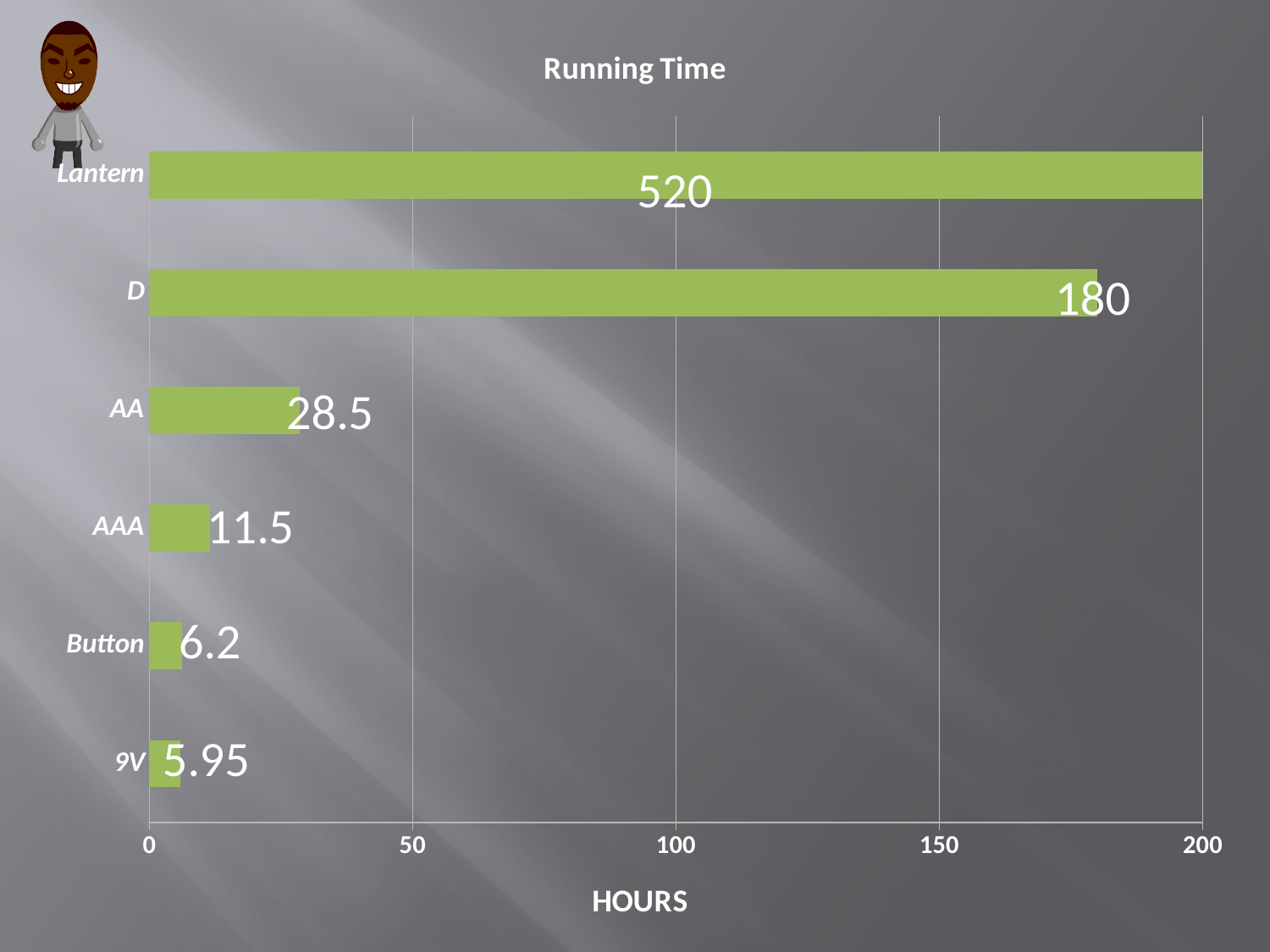
Which battery type has the lowest running time? 9V What kind of chart is shown on the slide? Bar chart Which battery type has the highest running time? Lantern What is the running time for the Lantern battery? 520 What is the running time for the D battery? 180 How many battery types are shown in the chart? 6 Which has a longer running time, AA or AAA? AA What is the difference in running time between the D and AA batteries? 151.5 What is the difference in running time between the AAA and Button batteries? 5.3 What is the running time for the AA battery? 28.5 What is the running time for the 9V battery? 5.95 What is the label of the horizontal axis? HOURS